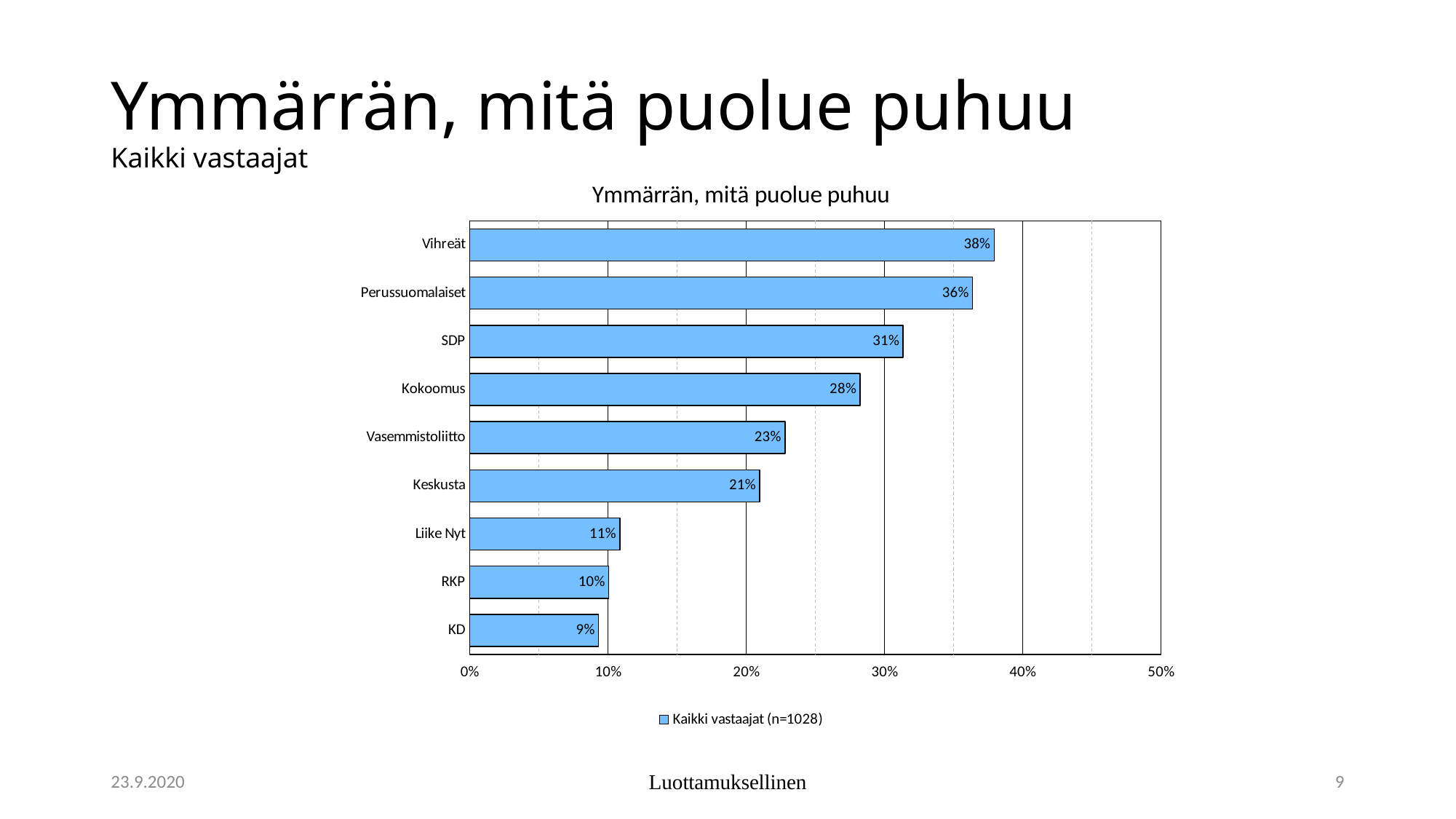
What is the value for Kokoomus? 28% How many series does the legend list? 1 Which has a larger value, Vasemmistoliitto or Keskusta? Vasemmistoliitto What is the value for Liike Nyt? 11% What is the difference between the values for Perussuomalaiset and SDP? 5% What kind of chart is shown on the slide? Bar chart Which party has the lowest value? KD How many parties are shown in the chart? 9 Which party has the highest value? Vihreät What is the value for Vihreät? 38% Is the value for SDP greater or less than 30%? greater What is the legend entry of the chart? Kaikki vastaajat (n=1028)